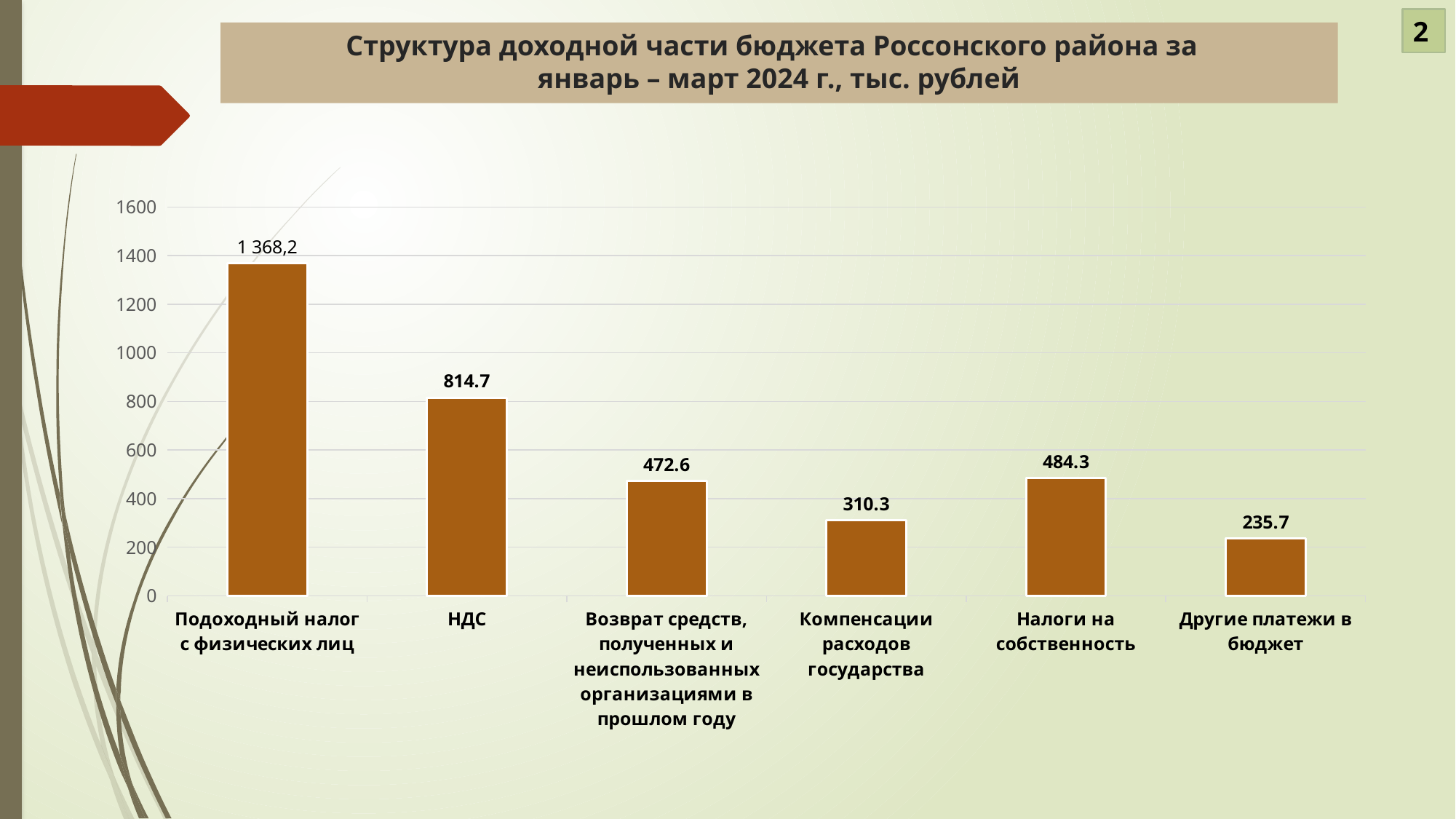
What is the value for Налоги на собственность? 484.3 What is the difference between the values for НДС and Возврат средств, полученных и неиспользованных организациями в прошлом году? 342.1 What is the difference between the values for Налоги на собственность and Компенсации расходов государства? 174.0 Which category has the highest value? Подоходный налог с физических лиц Which is larger: the value for Налоги на собственность or the value for Возврат средств, полученных и неиспользованных организациями в прошлом году? Налоги на собственность What is the value for Другие платежи в бюджет? 235.7 What is the value for НДС? 814.7 What kind of chart is shown on the slide? Bar chart What is the value for Подоходный налог с физических лиц? 1 368,2 Which category has the lowest value? Другие платежи в бюджет What is the title of the chart? Структура доходной части бюджета Россонского района за январь – март 2024 г., тыс. рублей How many categories are shown in the chart? 6